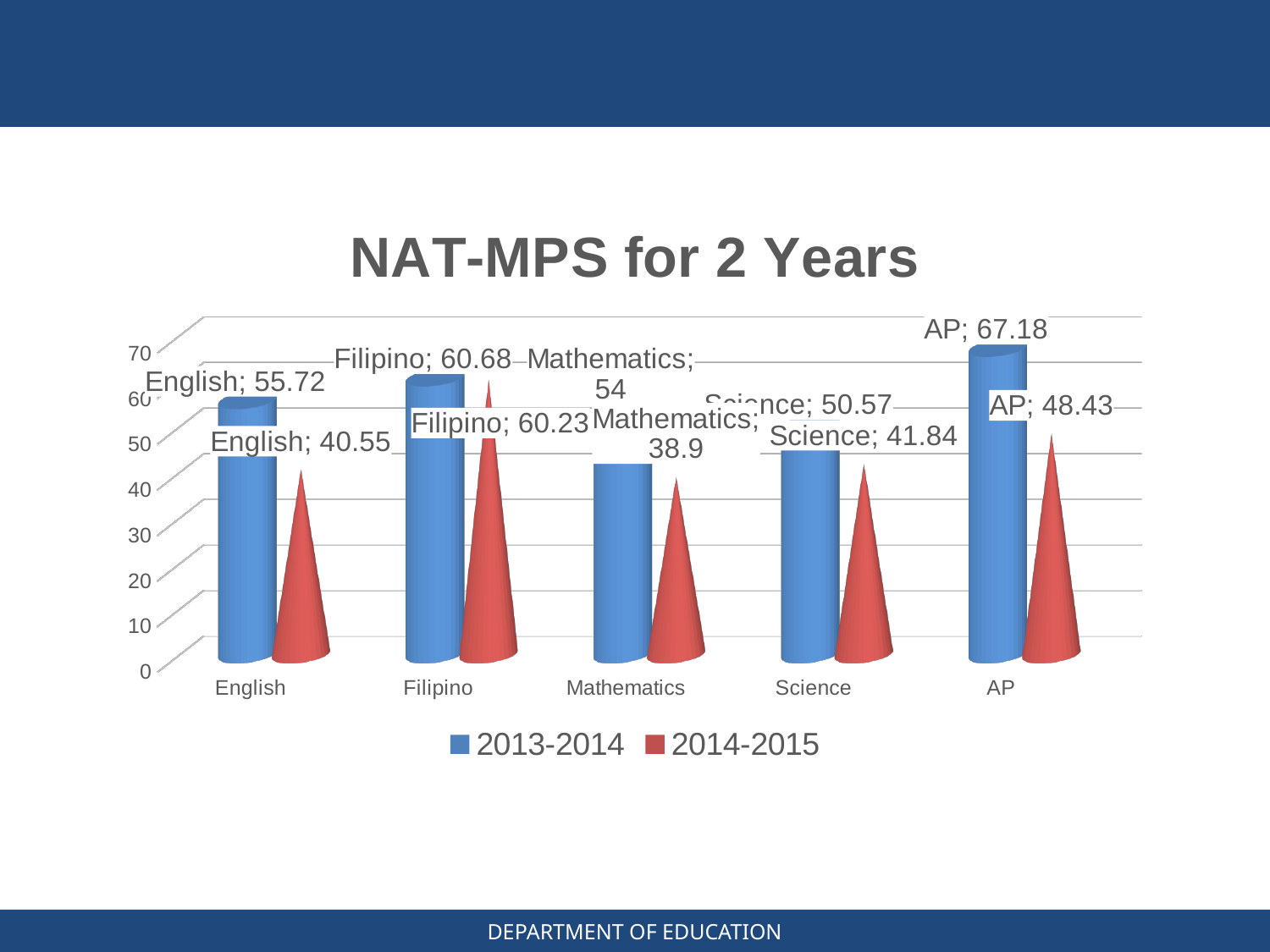
What is the difference between the 2013-2014 and 2014-2015 values for English? 15.17 How many subjects are shown on the x axis? 5 How many series does the legend list? 2 Is the 2013-2014 value for Mathematics greater or less than 50? greater What is the 2014-2015 value for AP? 48.43 What is the 2014-2015 value for Mathematics? 38.9 What is the title of the chart? NAT-MPS for 2 Years What is the 2013-2014 value for English? 55.72 Which subject has the lowest 2014-2015 value? Mathematics Which subject has the highest 2013-2014 value? AP What kind of chart is shown on the slide? Bar chart Which is larger for Science: the 2013-2014 value or the 2014-2015 value? 2013-2014